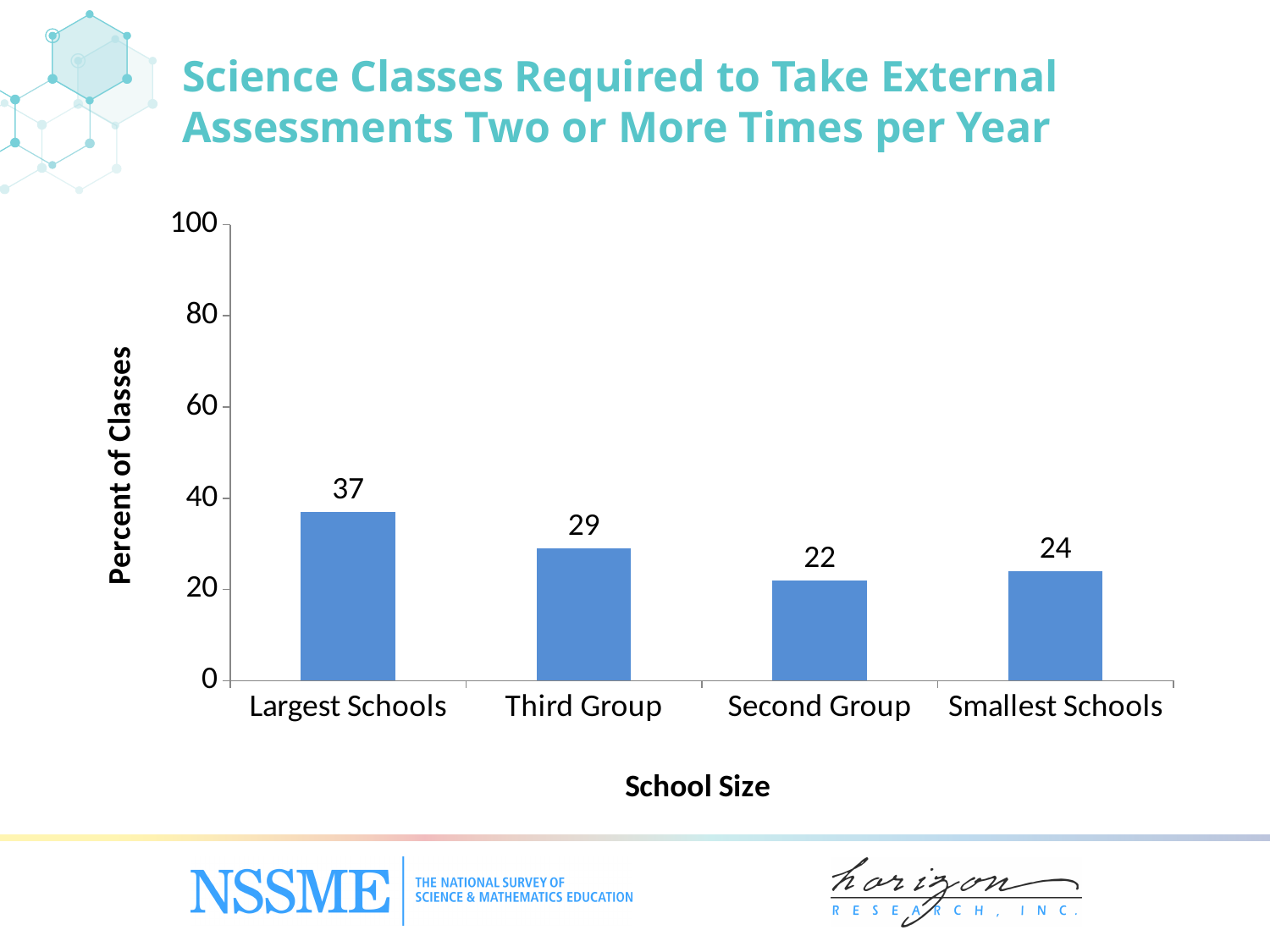
Which school size category has the highest percent of classes? Largest Schools Which school size category has the lowest percent of classes? Second Group What is the value for Third Group? 29 Is the value for Largest Schools greater or less than 40? less What is the value for Largest Schools? 37 How many school size categories are shown on the chart? 4 What is the label of the y axis? Percent of Classes What is the difference between the values for Largest Schools and Second Group? 15 What is the value for Second Group? 22 What kind of chart is shown on the slide? bar chart Which is larger, the value for Third Group or the value for Smallest Schools? Third Group What is the value for Smallest Schools? 24